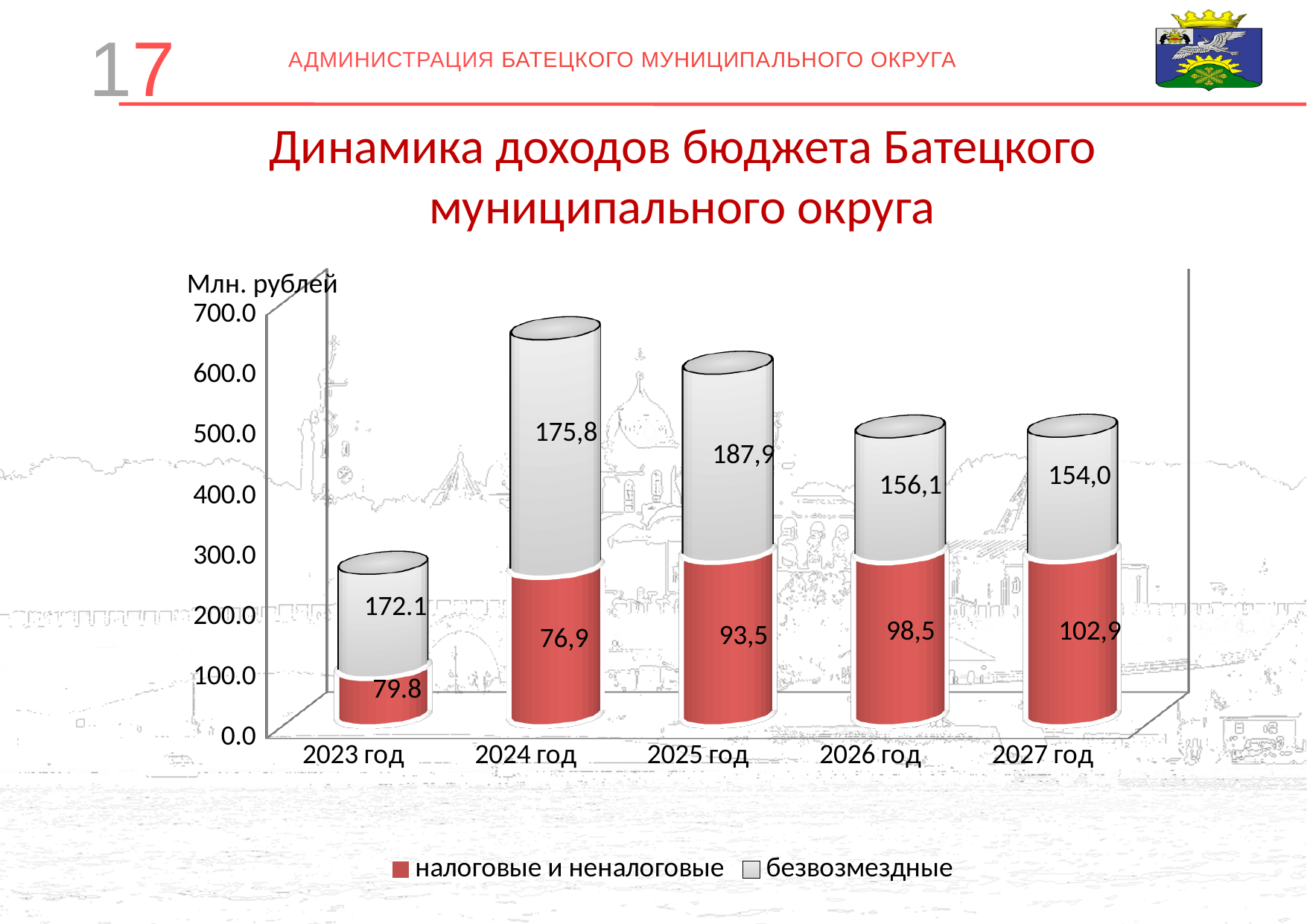
What unit is shown above the vertical axis? Млн. рублей How many series does the legend list? 2 What is the value for безвозмездные in 2026 год? 156,1 How many years are shown on the x axis? 5 In 2023 год, which is larger: безвозмездные or налоговые и неналоговые? безвозмездные What is the value for безвозмездные in 2025 год? 187,9 What is the value for налоговые и неналоговые in 2024 год? 76,9 What is the difference between безвозмездные and налоговые и неналоговые in 2025 год? 94,4 What kind of chart is shown on the slide? stacked bar chart What is the total of the stacked bar for 2027 год? 256,9 What is the value for налоговые и неналоговые in 2023 год? 79.8 What is the value for налоговые и неналоговые in 2027 год? 102,9